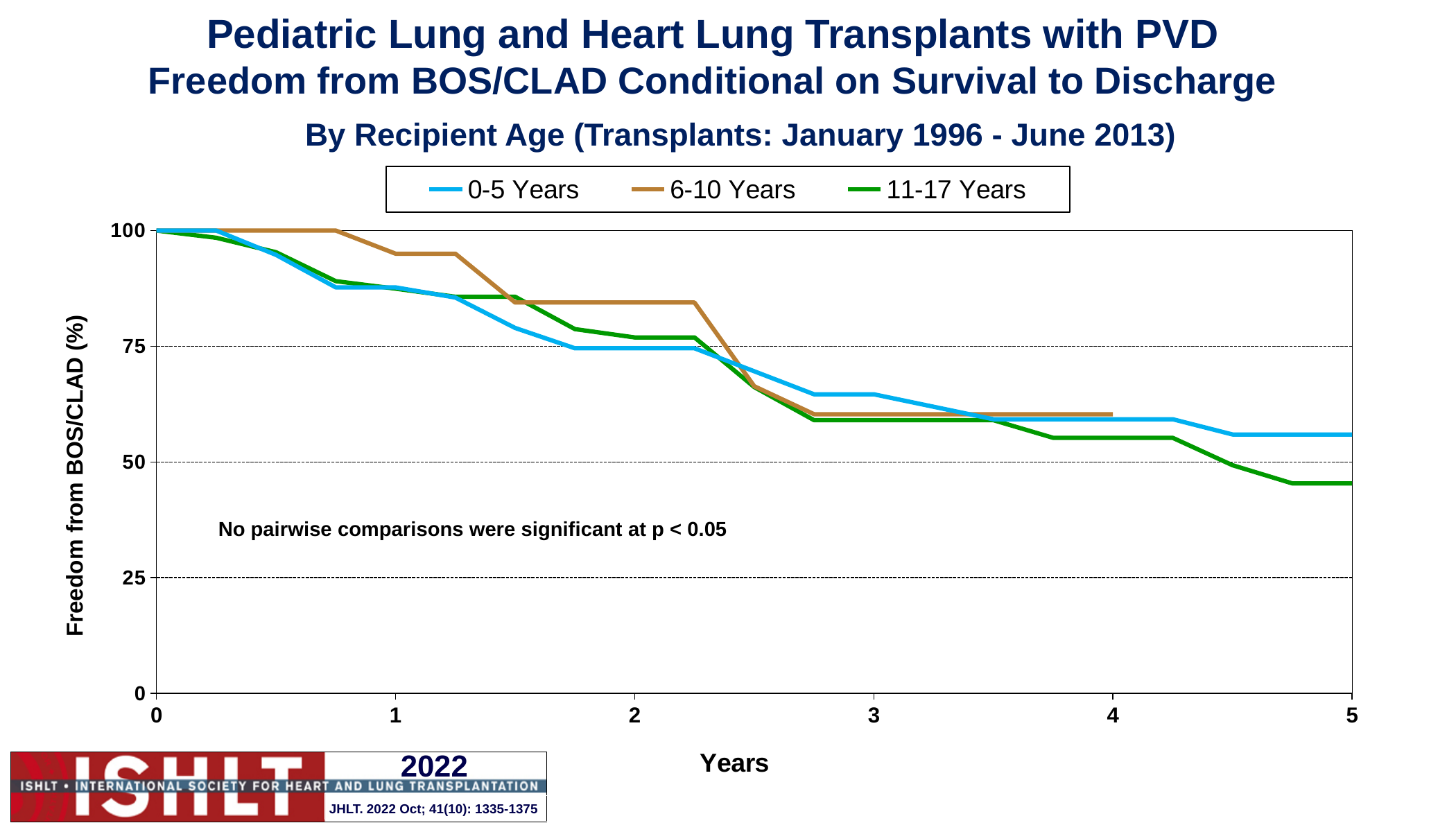
Do the values for the 11-17 Years group rise or fall as years increase? fall Which group has the lowest freedom from BOS/CLAD at 5 years? 11-17 Years What is the freedom from BOS/CLAD value for the 0-5 Years group at 0 years? 100 At 1 year, which group has the higher freedom from BOS/CLAD: 6-10 Years or 0-5 Years? 6-10 Years What kind of chart is shown on the slide? line chart How many series does the legend list? 3 Is the value for the 0-5 Years group at 3 years greater or less than 75? less Is the value for the 0-5 Years group at 5 years greater or less than 50? greater What is the label of the y axis? Freedom from BOS/CLAD (%) Is the value for the 6-10 Years group at 1 year greater or less than 75? greater At 5 years, which group has the higher freedom from BOS/CLAD: 0-5 Years or 11-17 Years? 0-5 Years